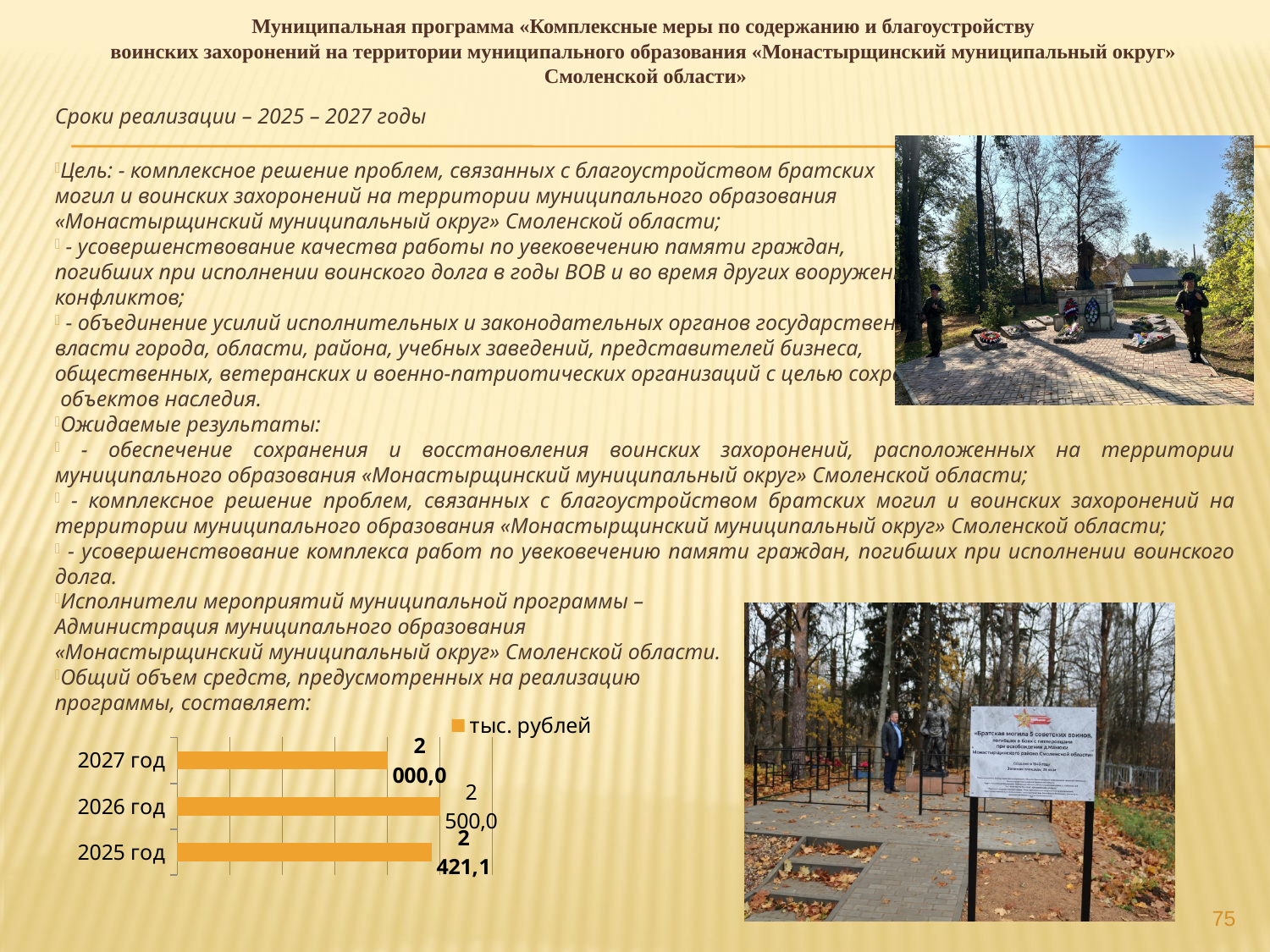
What is the value for 2027 год in the bar chart? 2 000,0 Which is larger, the value for 2025 год or the value for 2027 год? 2025 год How many categories (years) are shown in the bar chart? 3 Which year has the lowest value in the bar chart? 2027 год What is the difference between the values for 2026 год and 2027 год? 500,0 What is the legend entry of the chart? тыс. рублей What is the value for 2026 год in the bar chart? 2 500,0 What kind of chart is shown on the slide? Bar chart What is the difference between the values for 2026 год and 2025 год? 78,9 Which year has the highest value in the bar chart? 2026 год How many series does the chart legend list? 1 What is the value for 2025 год in the bar chart? 2 421,1